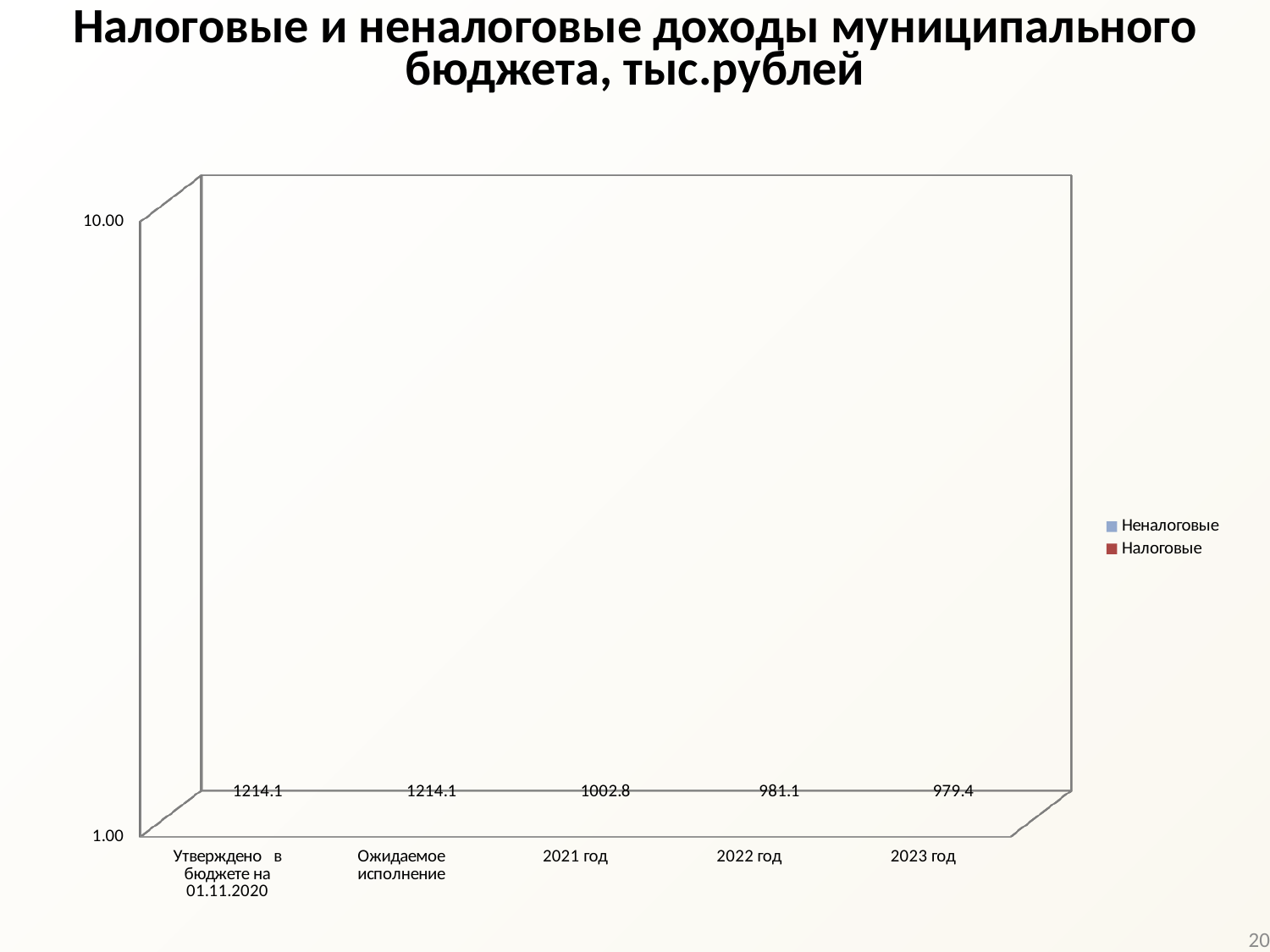
Which printed value is larger, the one for 2021 год or the one for 2023 год? 2021 год Which category has the lowest printed data label? 2023 год What data label is printed for the category 2022 год? 981.1 What kind of chart is shown on the slide? bar chart How many series does the chart legend list? 2 What data label is printed for the category Ожидаемое исполнение? 1214.1 What data label is printed for the category 2023 год? 979.4 What are the two entries listed in the chart legend? Неналоговые, Налоговые How many categories are shown along the x axis of the chart? 5 What is the difference between the printed values for 2021 год and 2022 год? 21.7 What data label is printed for the category 2021 год? 1002.8 Do the printed data labels rise or fall from 2021 год to 2023 год? fall